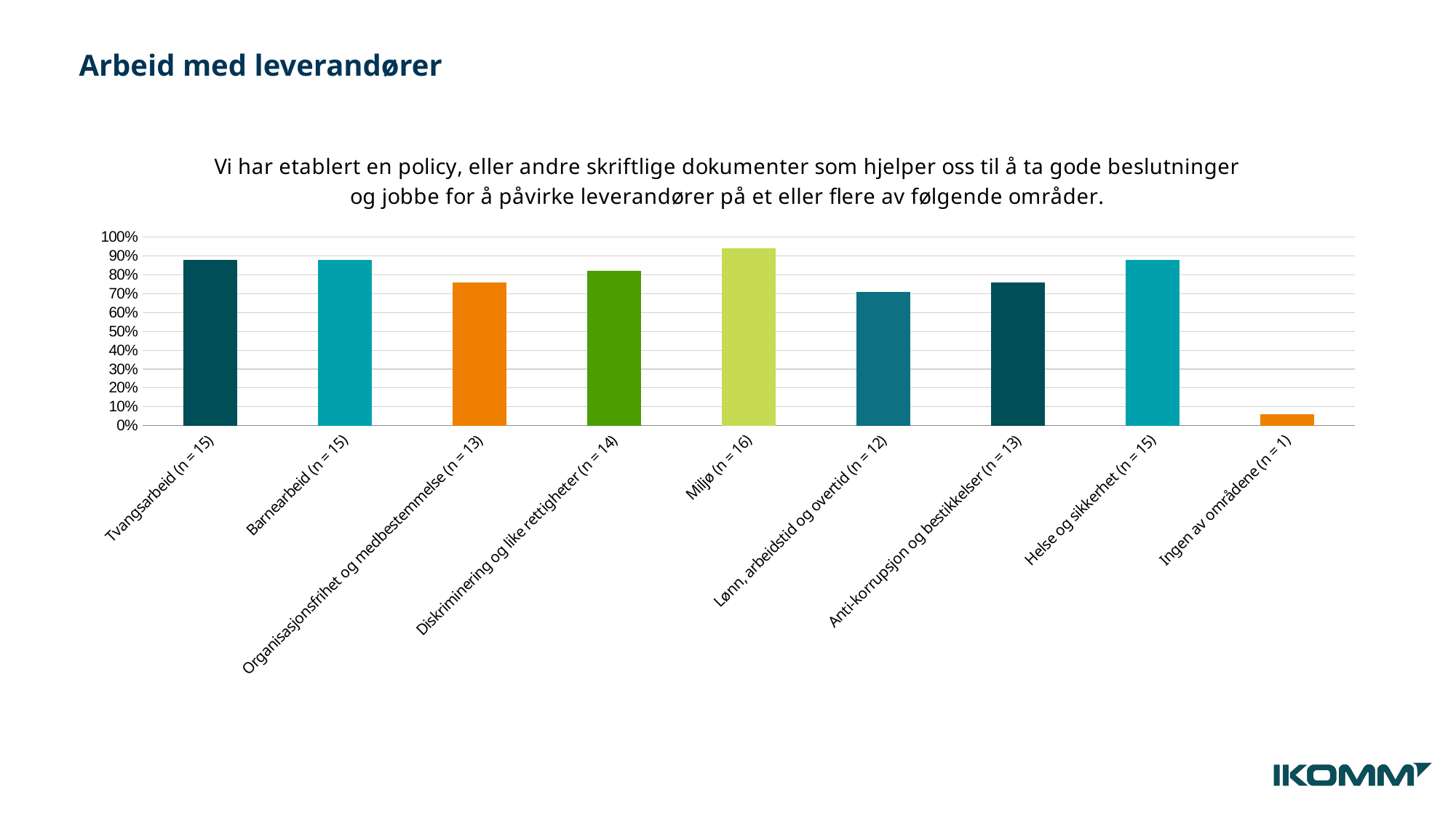
Is the value for Miljø (n = 16) greater or less than 90%? greater Is the value for Tvangsarbeid (n = 15) greater or less than 80%? greater Is the value for Lønn, arbeidstid og overtid (n = 12) greater or less than 80%? less What kind of chart is shown on the slide? bar chart What is the highest value shown on the y axis? 100% Which category has the lowest bar? Ingen av områdene (n = 1) Which is larger, the value for Diskriminering og like rettigheter (n = 14) or the value for Anti-korrupsjon og bestikkelser (n = 13)? Diskriminering og like rettigheter (n = 14) How many categories are plotted on the x axis? 9 Which is larger, the value for Miljø (n = 16) or the value for Lønn, arbeidstid og overtid (n = 12)? Miljø (n = 16) Which category has the highest bar? Miljø (n = 16)